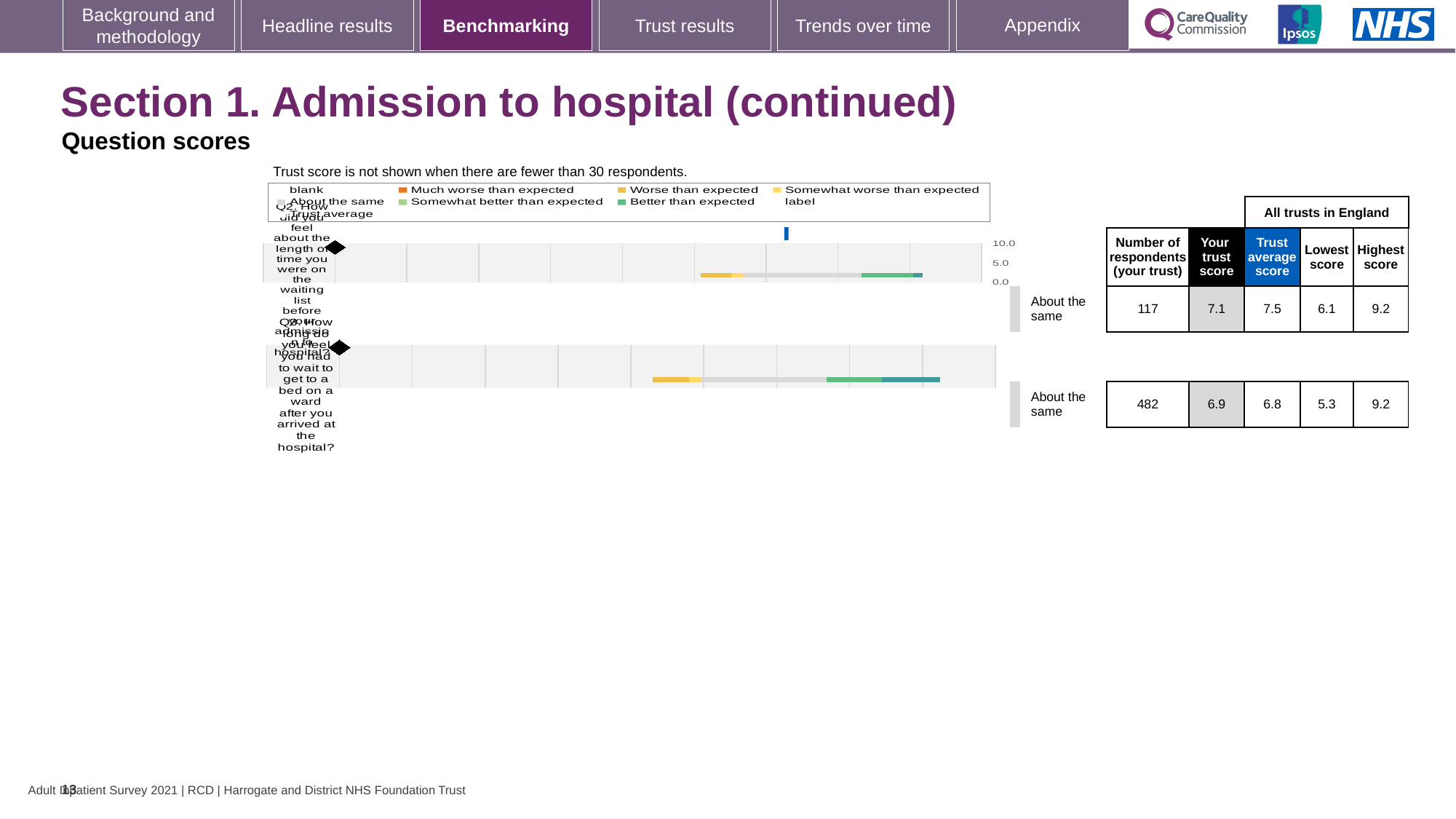
How many respondents answered Q3 for this trust? 482 How many respondents answered Q2 for this trust? 117 What is the lowest score among all trusts in England for Q3? 5.3 What is the trust average score across all trusts in England for Q2? 7.5 What is the trust score for Q3 (wait to get to a bed on a ward after arriving at the hospital)? 6.9 What is the difference between the trust average score and this trust's score for Q2? 0.4 How many questions are plotted in the chart? 2 What kind of chart is used to show the question scores? Bar chart What is the highest score among all trusts in England for Q2? 9.2 What benchmark category is shown for both Q2 and Q3? About the same What is the trust score for Q2 (length of time on the waiting list before admission)? 7.1 Which question has the higher trust score for this trust, Q2 or Q3? Q2